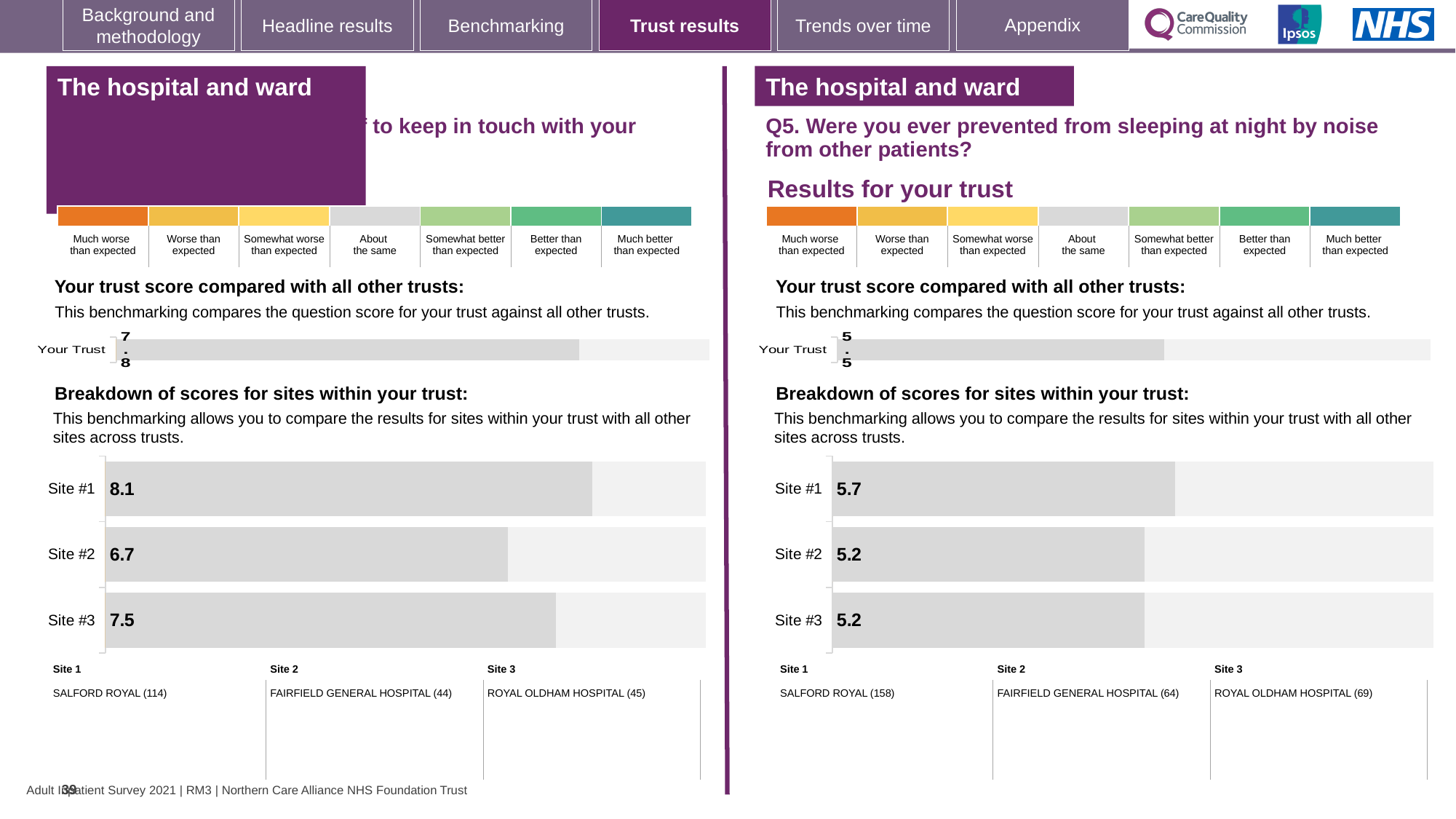
On the left-hand slide, which site has the lowest score in the breakdown of scores for sites? Site #2 On the left-hand slide, what is the score for Site #2 in the breakdown of scores for sites? 6.7 On the right-hand slide (Q5), what is the difference between the scores for Site #1 and Site #3? 0.5 On the left-hand slide, what is the score for Your Trust? 7.8 What type of chart is used for the breakdown of scores for sites on the left-hand slide? Bar chart On the left-hand slide, which site has the highest score in the breakdown of scores for sites? Site #1 On the left-hand slide, which is larger: the score for Site #3 or the score for Site #2? Site #3 On the right-hand slide (Q5), what is the score for Site #1 in the breakdown of scores for sites? 5.7 On the right-hand slide (Q5), which site has the highest score in the breakdown of scores for sites? Site #1 On the left-hand slide, what is the difference between the scores for Site #1 and Site #2? 1.4 On the right-hand slide (Q5, prevented from sleeping by noise from other patients), what is the score for Your Trust? 5.5 How many sites are shown in the breakdown of scores chart on the right-hand slide (Q5)? 3